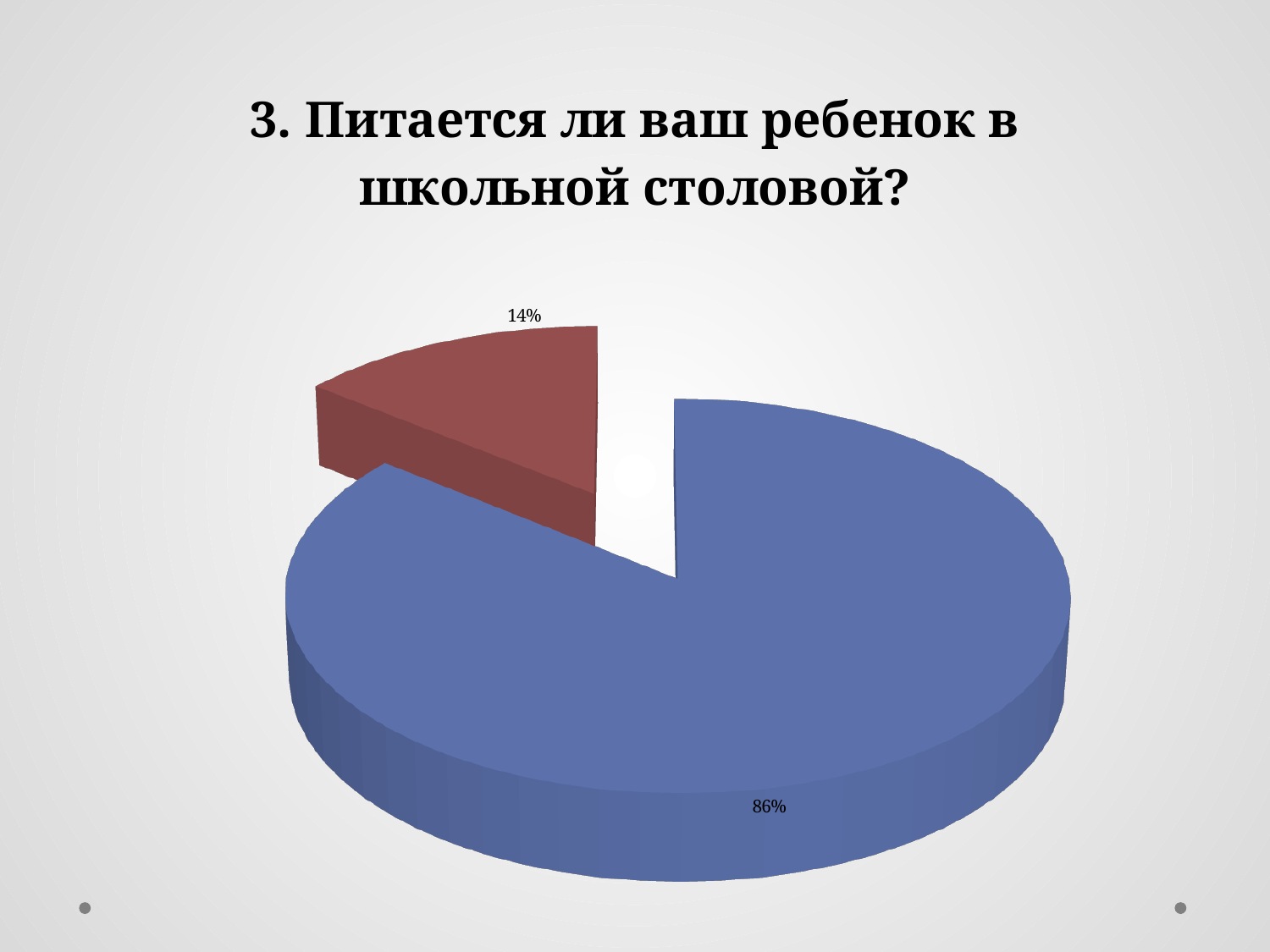
What is the difference in percentage points between the blue slice and the red slice? 72 What is the title of the chart on the slide? 3. Питается ли ваш ребенок в школьной столовой? Which slice of the pie chart is pulled out (exploded) from the rest? the red slice (14%) What share of the pie does the red slice represent? 14% Which slice of the pie chart is the smallest? the red slice (14%) Which slice is larger, the blue one or the red one? the blue one How many slices does the pie chart have? 2 What percentage is shown on the blue slice of the pie chart? 86% What kind of chart is shown on the slide? pie chart Which slice of the pie chart is the largest? the blue slice (86%) What percentage is shown on the red slice of the pie chart? 14%